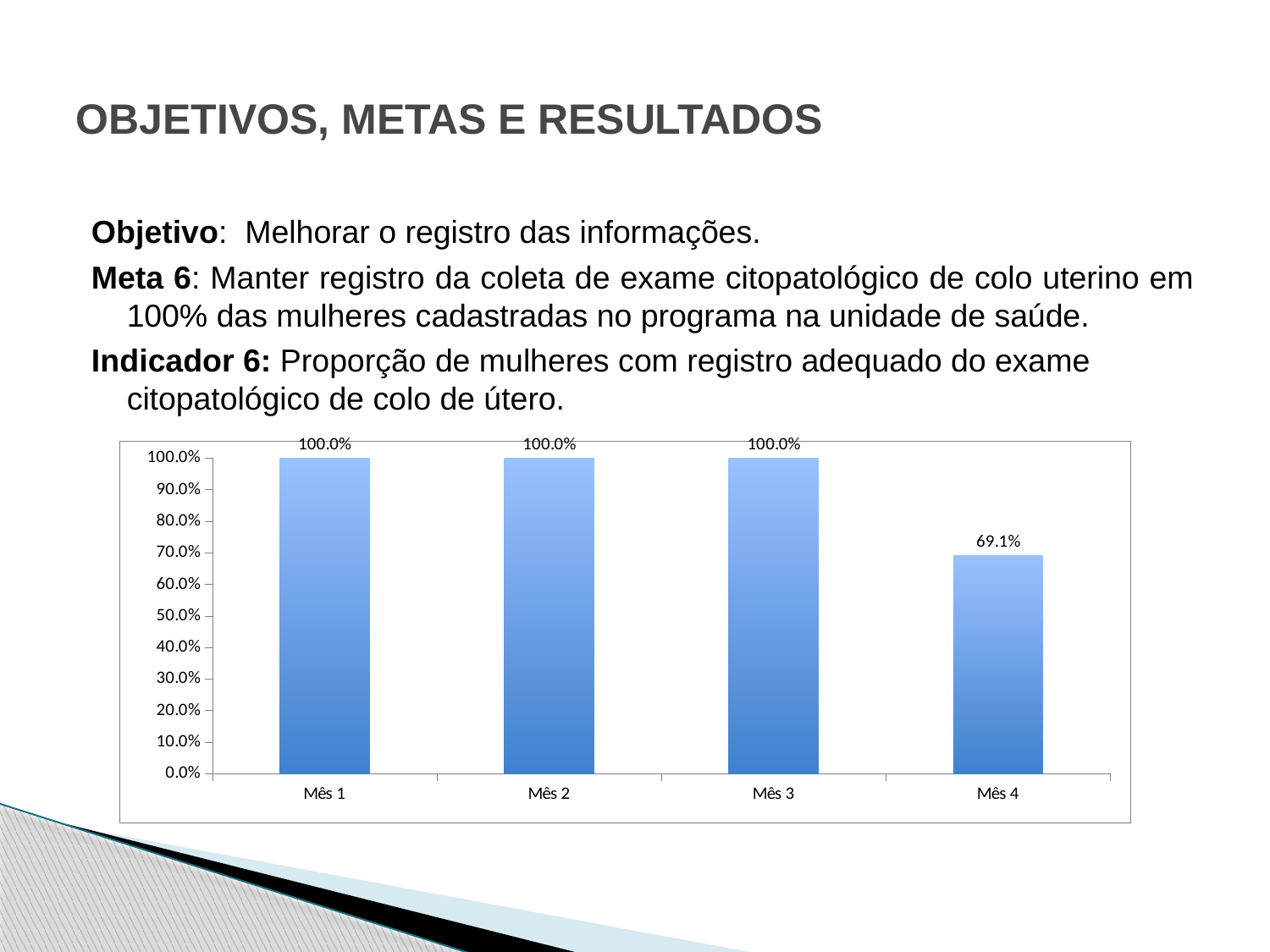
Is the value for Mês 4 greater or less than 60.0%? greater What kind of chart is shown on the slide? bar chart What is the highest value shown on the y axis? 100.0% Do the values rise or fall from Mês 3 to Mês 4? fall How many months have a value of 100.0%? 3 Which is larger, the value for Mês 2 or the value for Mês 4? Mês 2 Which month has the lowest value? Mês 4 What is the value for Mês 4? 69.1% What is the value for Mês 3? 100.0% What is the value for Mês 1? 100.0% What is the difference between the values for Mês 3 and Mês 4? 30.9% How many months are shown on the x axis? 4